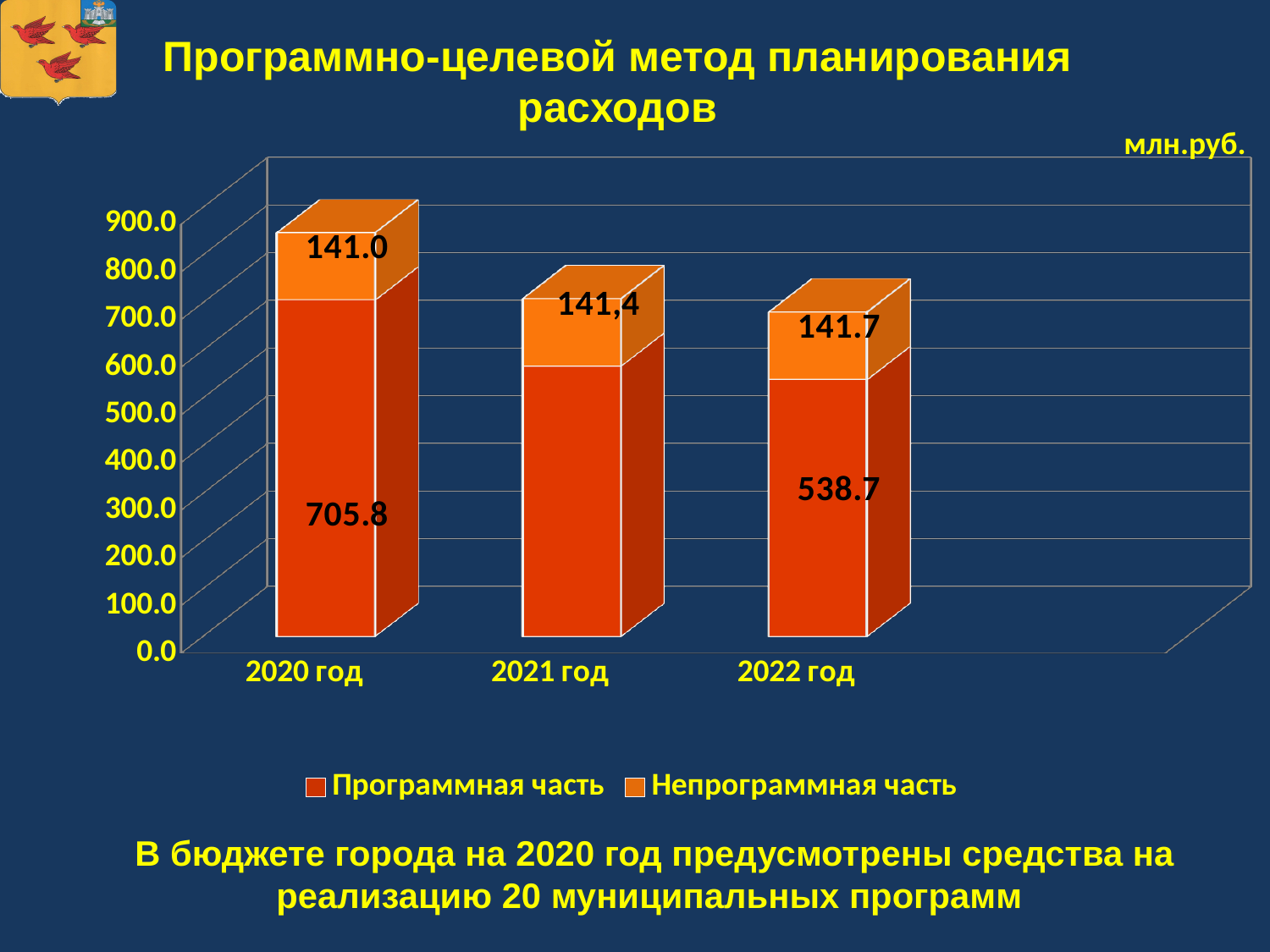
What is the value of Непрограммная часть for 2022 год? 141.7 Which year has the highest value for Программная часть? 2020 год Is the value of Программная часть for 2021 год greater or less than 500? greater Which is larger: Непрограммная часть for 2020 год or for 2022 год? 2022 год What is the value of Программная часть for 2020 год? 705.8 How many years are shown on the x axis? 3 What kind of chart is shown on the slide? stacked bar chart Which year has the lowest value for Программная часть? 2022 год How many series does the legend list? 2 What is the value of Непрограммная часть for 2021 год? 141,4 What is the total of the stacked bar for 2020 год? 846.8 What is the difference between the Программная часть values for 2020 год and 2022 год? 167.1